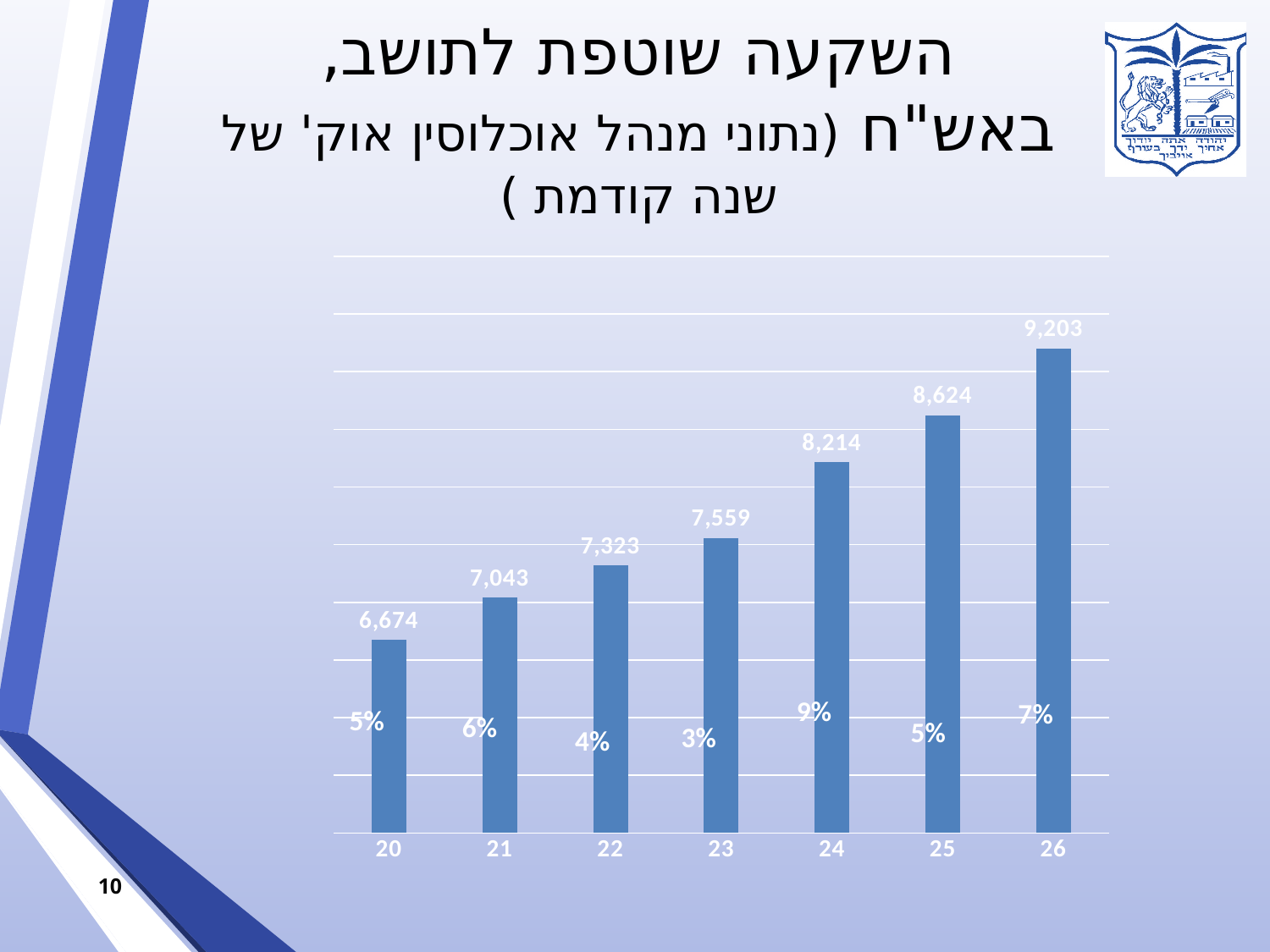
Which is larger, the value for category 23 or the value for category 22? 23 What kind of chart is shown on the slide? bar chart What is the difference between the values for categories 26 and 25? 579 Which category has the lowest percentage label shown on its bar? 23 What is the value for category 24? 8,214 What is the difference between the values for categories 21 and 20? 369 How many bars are plotted in the chart? 7 Which category has the highest value? 26 What percentage label is shown on the bar for category 24? 9% Do the bar values rise or fall from category 20 to category 26? rise Which category has the lowest value? 20 What is the value for category 20? 6,674